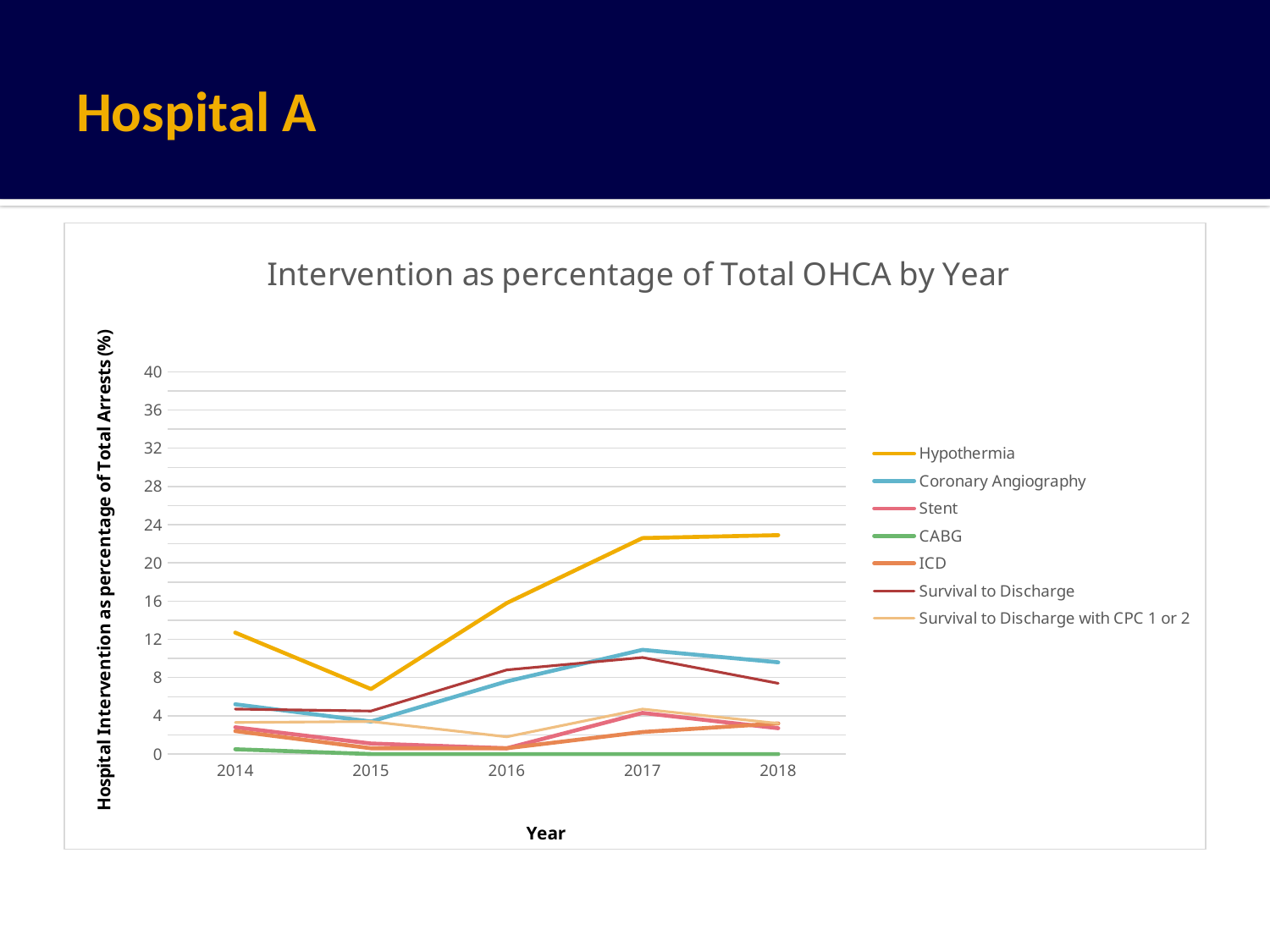
Is the value for Coronary Angiography in 2017 greater or less than 8? greater What is the title of the chart? Intervention as percentage of Total OHCA by Year Which series has the highest value in 2018? Hypothermia How many years are plotted along the x axis? 5 Is the value for Hypothermia in 2017 greater or less than 20? greater Is the value for Hypothermia in 2015 greater or less than 8? less How many series does the legend list? 7 Which is larger, the Hypothermia value in 2014 or in 2018? 2018 What kind of chart is shown on the slide? line chart In which year is the Hypothermia value lowest? 2015 Does the Hypothermia line rise or fall from 2015 to 2017? rise What is the label of the y axis? Hospital Intervention as percentage of Total Arrests (%)